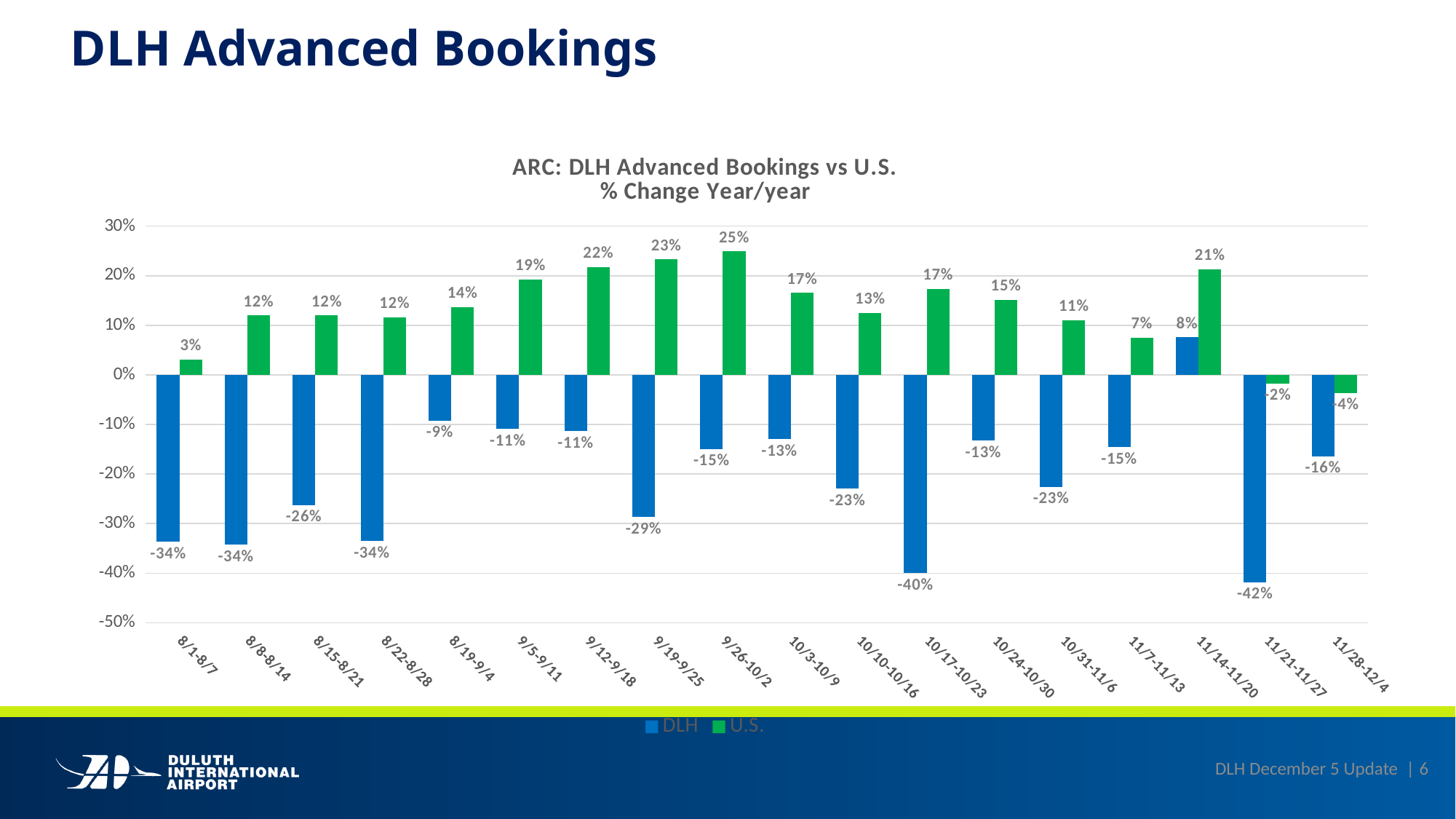
How many series does the legend list? 2 What is the U.S. value for the 11/28-12/4 week? -4% What kind of chart is shown on the slide? Bar chart Which week has the highest DLH value? 11/14-11/20 How many weekly categories are shown on the x axis? 18 What is the DLH value for the 11/14-11/20 week? 8% Which week has the highest U.S. value? 9/26-10/2 What is the U.S. value for the 9/26-10/2 week? 25% For the 11/14-11/20 week, what is the difference between the U.S. value and the DLH value? 13 percentage points Which is larger, the DLH value for 8/15-8/21 or the DLH value for 8/22-8/28? 8/15-8/21 Which week has the lowest DLH value? 11/21-11/27 What is the DLH value for the 10/17-10/23 week? -40%